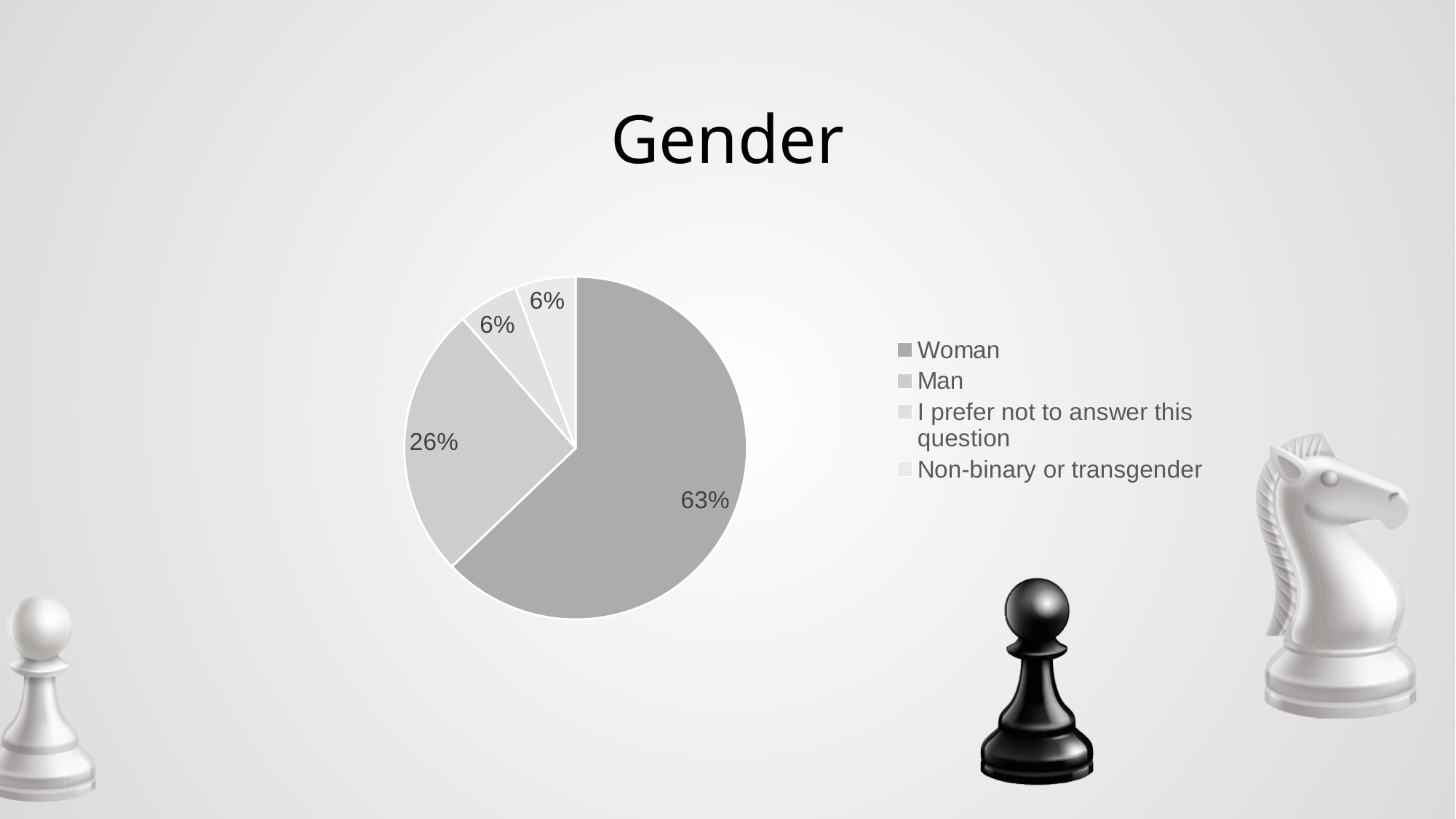
How many entries does the legend list? 4 What is the difference between the Woman and Man slices? 37% What percentage of the pie is labelled Man? 26% What percentage of the pie is labelled 'I prefer not to answer this question'? 6% What is the difference between the Man slice and the Non-binary or transgender slice? 20% What percentage of the pie is labelled Non-binary or transgender? 6% Which category has the largest slice of the pie? Woman Which slice is larger, Woman or Man? Woman How many categories does the pie chart have? 4 What is the title of the chart? Gender What percentage of the pie is labelled Woman? 63% What type of chart is shown on the slide? pie chart